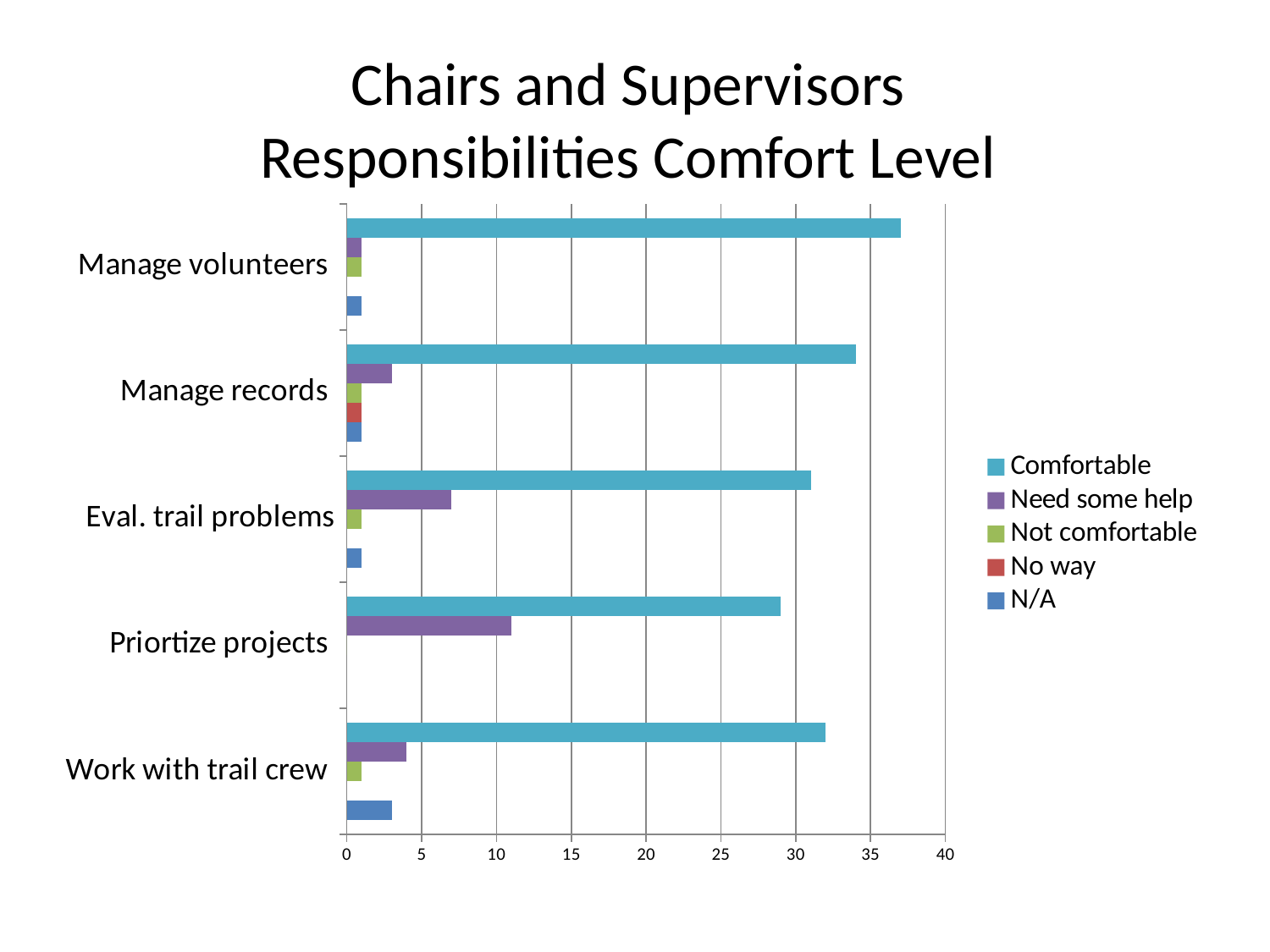
Is the Comfortable value for Priortize projects greater or less than 30? less Is the Need some help value for Eval. trail problems greater or less than 5? greater Is the Comfortable value for Manage volunteers greater or less than 35? greater Which has the larger Comfortable value, Manage records or Eval. trail problems? Manage records Which has the larger Need some help value, Priortize projects or Work with trail crew? Priortize projects Which category has the highest Need some help value? Priortize projects Which category has the lowest Comfortable value? Priortize projects How many series does the legend list? 5 What kind of chart is shown on the slide? bar chart How many responsibility categories are shown on the chart? 5 What is the title of the chart? Chairs and Supervisors Responsibilities Comfort Level Which category has the highest Comfortable value? Manage volunteers